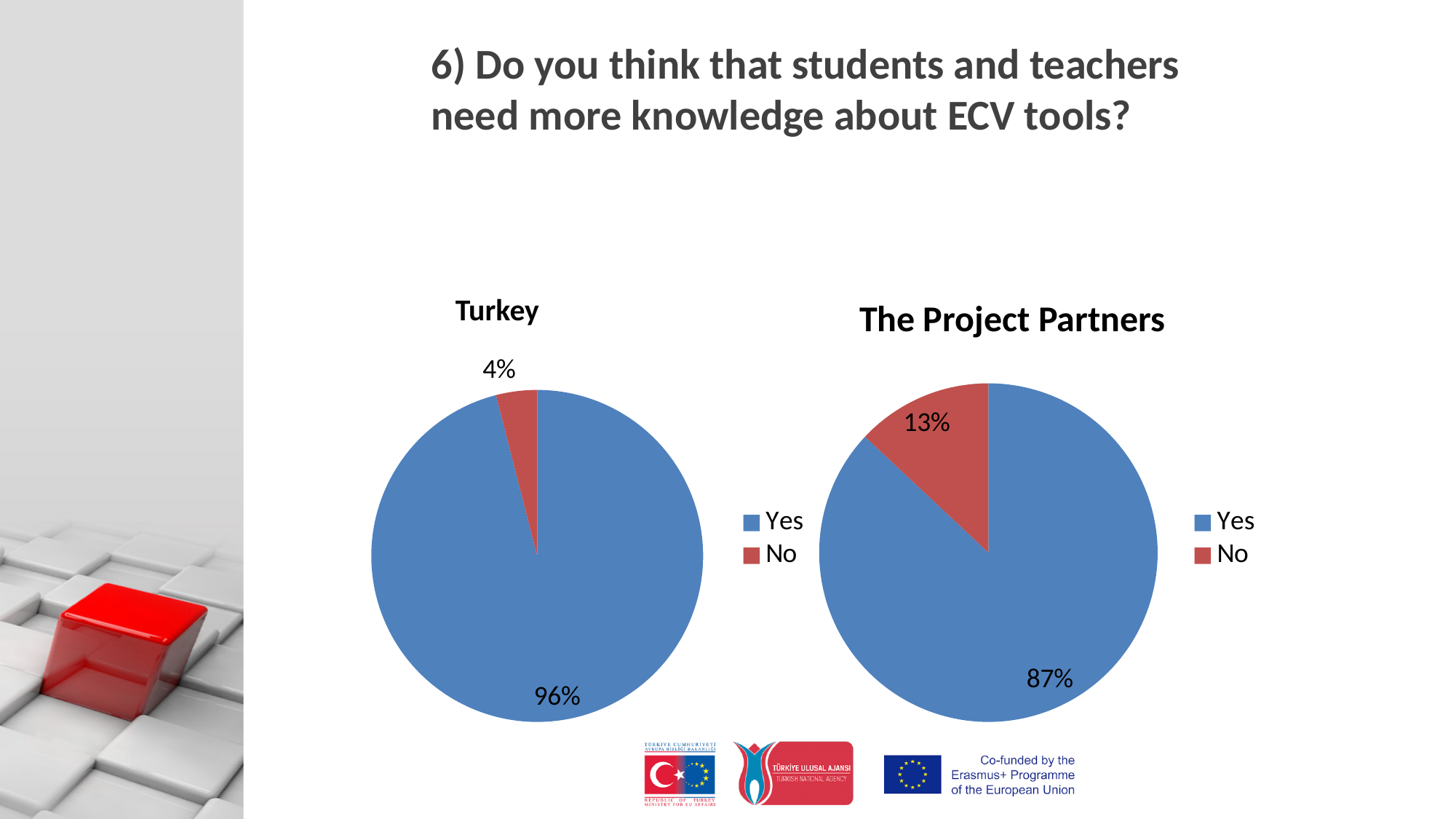
In the Turkey chart, which response has the largest slice? Yes How many slices does The Project Partners chart have? 2 How many entries does the legend of the Turkey chart list? 2 In The Project Partners chart, what percentage answered Yes? 87% In the Turkey chart, what percentage answered Yes? 96% In The Project Partners chart, which response has the smallest slice? No In The Project Partners chart, what percentage answered No? 13% Which chart shows a larger No share, Turkey or The Project Partners? The Project Partners In the Turkey chart, what percentage answered No? 4% In The Project Partners chart, what colour represents No? Red What type of chart is the Turkey chart? Pie chart What is the difference between the Yes share in the Turkey chart and the Yes share in The Project Partners chart? 9%